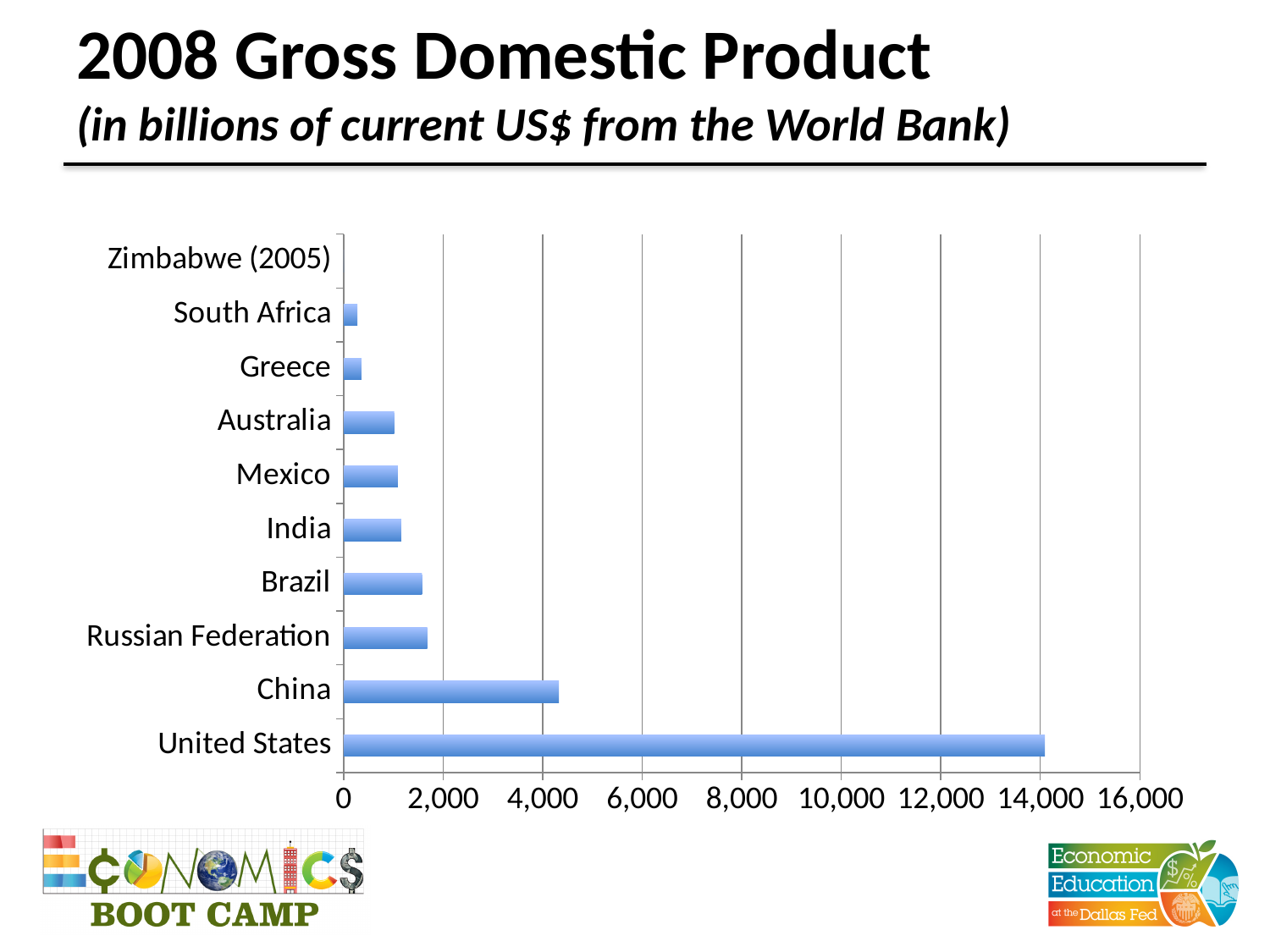
Is the value for China greater or less than 4,000? greater Which has a larger GDP, Australia or Greece? Australia Is the value for the Russian Federation greater or less than 2,000? less What kind of chart is shown on the slide? bar chart Which has a larger GDP, China or the Russian Federation? China How many countries are shown in the chart? 10 Is the value for the United States greater or less than 12,000? greater Which country has the highest 2008 GDP in the chart? United States What is the title of the chart? 2008 Gross Domestic Product Which country has the lowest GDP in the chart? Zimbabwe (2005)